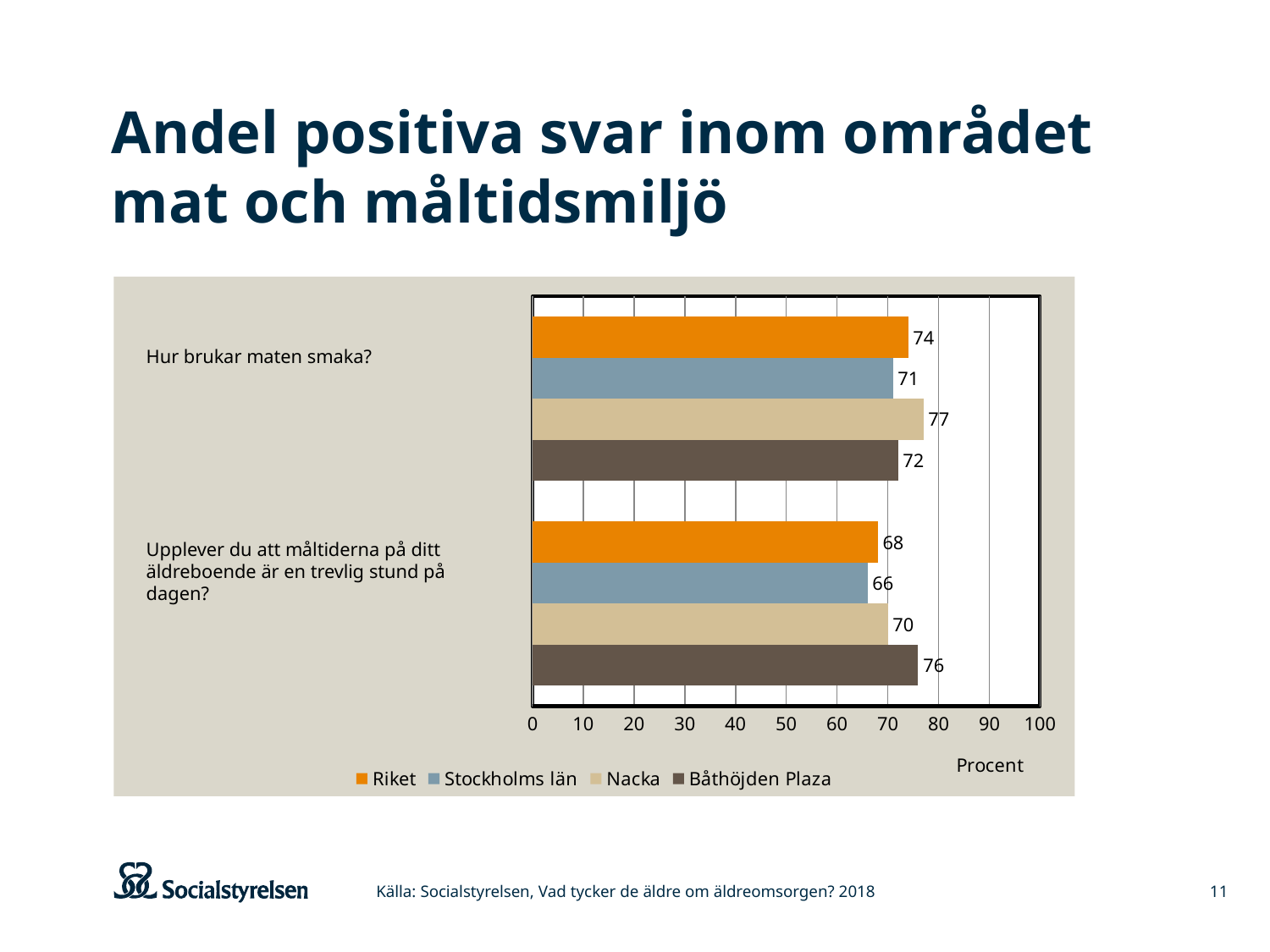
Which is larger for Båthöjden Plaza: the value for "Hur brukar maten smaka?" or the value for "Upplever du att måltiderna på ditt äldreboende är en trevlig stund på dagen?"? Upplever du att måltiderna på ditt äldreboende är en trevlig stund på dagen? What is the label on the horizontal axis of the chart? Procent What is the difference between the Båthöjden Plaza and Riket values for the question "Upplever du att måltiderna på ditt äldreboende är en trevlig stund på dagen?"? 8 What is the value for Båthöjden Plaza for the question "Upplever du att måltiderna på ditt äldreboende är en trevlig stund på dagen?"? 76 Which series has the highest value for the question "Hur brukar maten smaka?"? Nacka What is the value for Stockholms län for the question "Hur brukar maten smaka?"? 71 What kind of chart is shown on the slide? Bar chart What is the value for Nacka for the question "Hur brukar maten smaka?"? 77 How many series does the legend list? 4 What is the difference between the Nacka and Stockholms län values for the question "Hur brukar maten smaka?"? 6 Which series has the lowest value for the question "Upplever du att måltiderna på ditt äldreboende är en trevlig stund på dagen?"? Stockholms län Is the value for Riket for the question "Upplever du att måltiderna på ditt äldreboende är en trevlig stund på dagen?" greater or less than 70? less